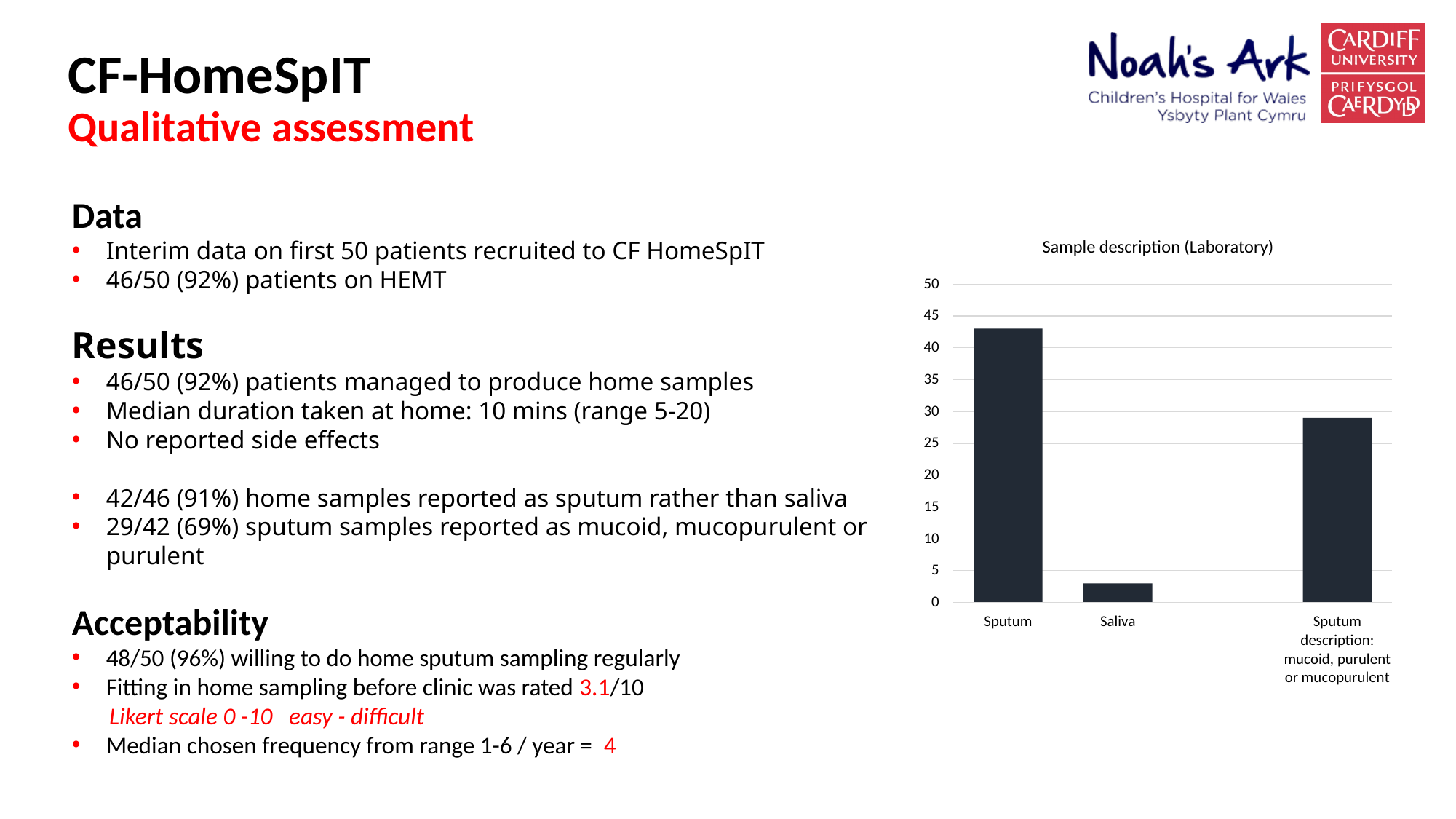
Which is larger in the chart, the value for Sputum or the value for Saliva? Sputum What type of chart is shown under the title 'Sample description (Laboratory)'? bar chart Is the value for 'Sputum description: mucoid, purulent or mucopurulent' greater or less than 25? greater Is the value for Saliva greater or less than 5? less Which is larger in the chart, the value for Saliva or the value for 'Sputum description: mucoid, purulent or mucopurulent'? Sputum description: mucoid, purulent or mucopurulent Is the value for Sputum greater or less than 40? greater Which category has the highest bar in the 'Sample description (Laboratory)' chart? Sputum Which category has the lowest bar in the 'Sample description (Laboratory)' chart? Saliva What is the maximum value shown on the y axis of the chart? 50 How many categories are shown on the x axis of the 'Sample description (Laboratory)' chart? 3 What is the title of the chart on the slide? Sample description (Laboratory)